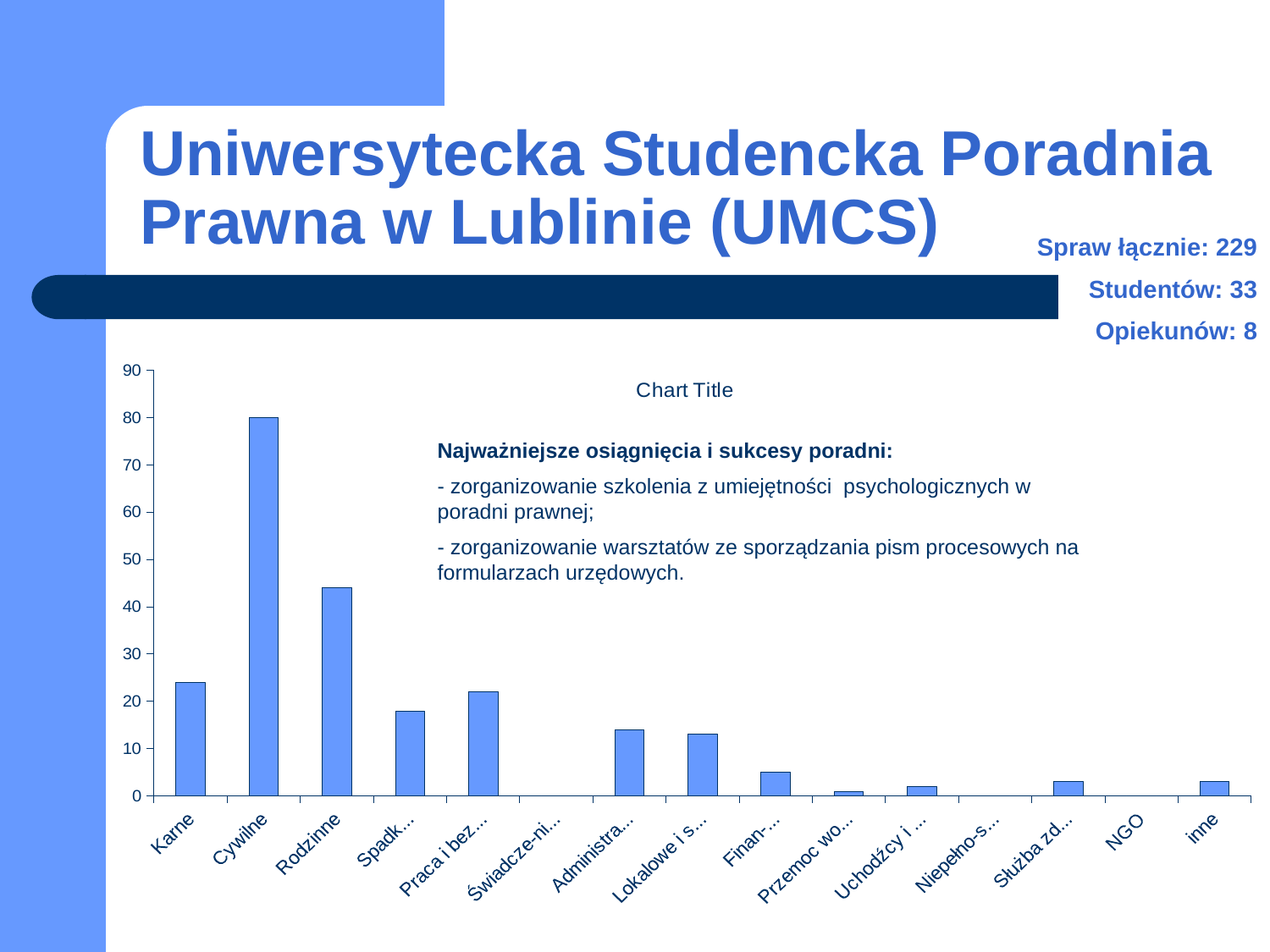
Is the value for NGO greater or less than 10? less Which category has the highest bar in the chart? Cywilne How many categories are shown on the x axis of the chart? 15 Is the value for Cywilne greater or less than 70? greater What is the value for Cywilne in the chart? 80 What is the title shown on the chart? Chart Title Is the value for inne greater or less than 10? less Which is larger, the value for Karne or the value for Rodzinne? Rodzinne Which is larger, the value for Cywilne or the value for Karne? Cywilne What kind of chart is shown on the slide? bar chart